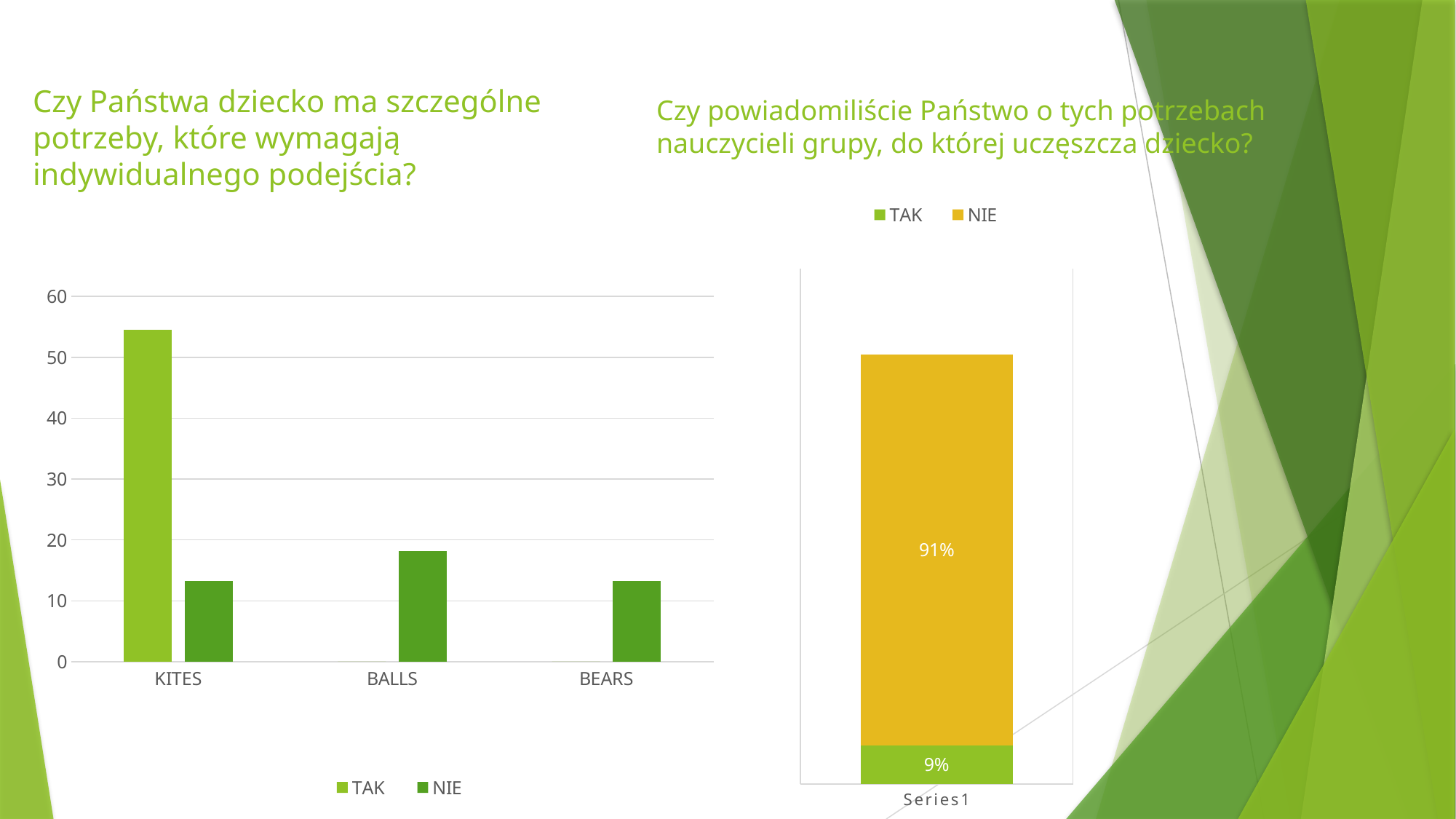
On the right chart, what is the difference between the NIE and TAK values? 82% On the left chart, is the NIE value for KITES greater or less than 10? greater On the right chart, what is the value for TAK? 9% On the left chart, which is larger for KITES: TAK or NIE? TAK On the left chart, is the NIE value for BALLS greater or less than 20? less On the left chart, is the TAK value for KITES greater or less than 50? greater On the left chart, which category has the highest TAK value? KITES On the left chart, which category has the highest NIE value? BALLS What kind of chart is the left chart? bar chart How many categories are shown on the x axis of the left chart? 3 How many series does the legend of the left chart list? 2 On the right chart, what is the value for NIE? 91%